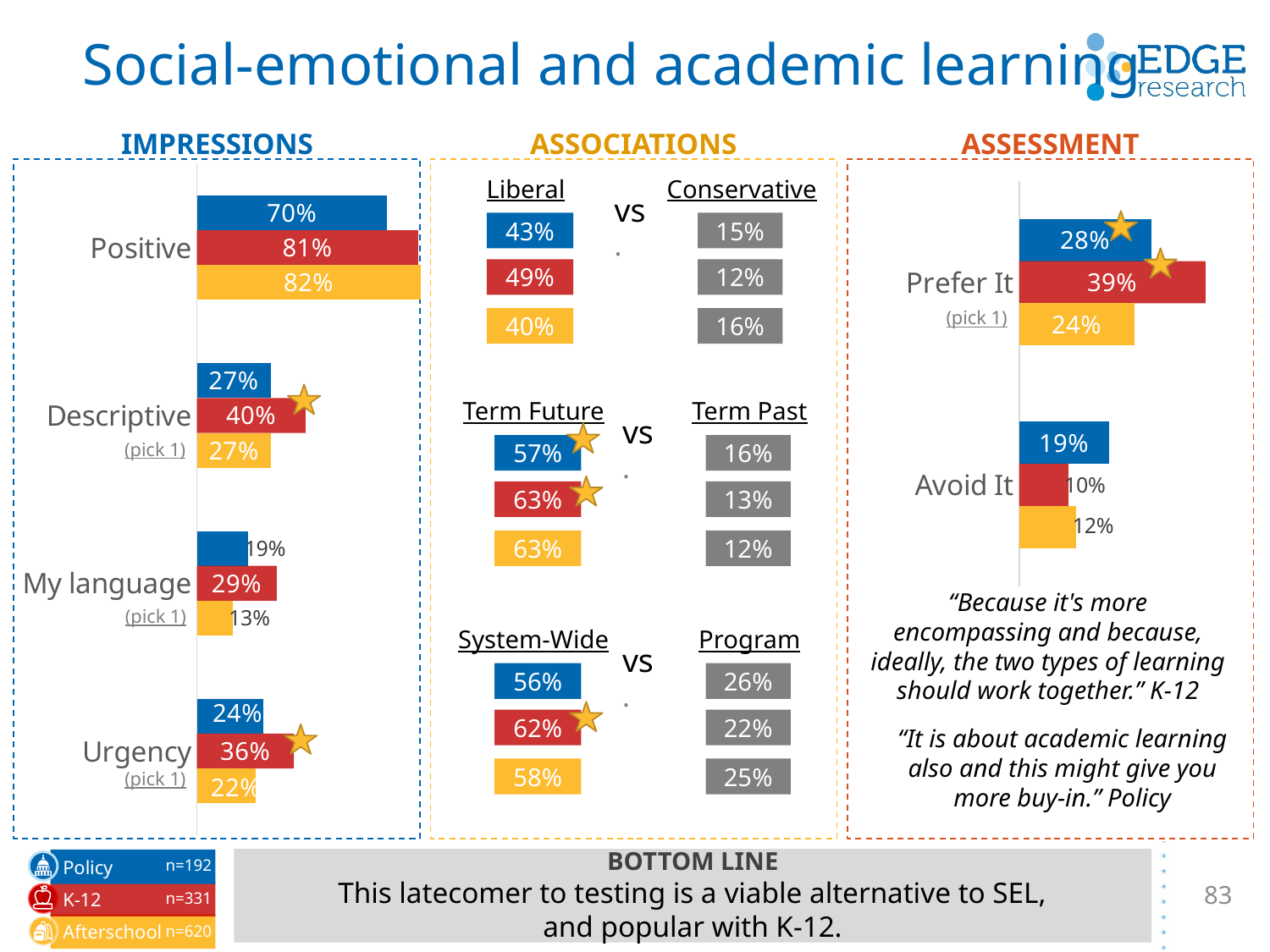
What type of chart is the IMPRESSIONS chart? Bar chart In the IMPRESSIONS chart, what is the difference between the K-12 and Policy values for Urgency? 12% In the ASSESSMENT chart, what is the K-12 value for Prefer It? 39% In the IMPRESSIONS chart, what is the Policy value for Urgency? 24% In the ASSESSMENT chart, what is the difference between the K-12 and Afterschool values for Prefer It? 15% In the ASSESSMENT chart, which group has the lowest value for Avoid It? K-12 In the ASSESSMENT chart, what is the Policy value for Avoid It? 19% In the IMPRESSIONS chart, what is the Afterschool value for Positive? 82% In the IMPRESSIONS chart, what percentage of K-12 respondents rated the term Positive? 81% In the IMPRESSIONS chart, which group has the highest value for Descriptive? K-12 In the IMPRESSIONS chart, how many categories are shown on the vertical axis? 4 In the IMPRESSIONS chart, which group has the lowest value for My language? Afterschool